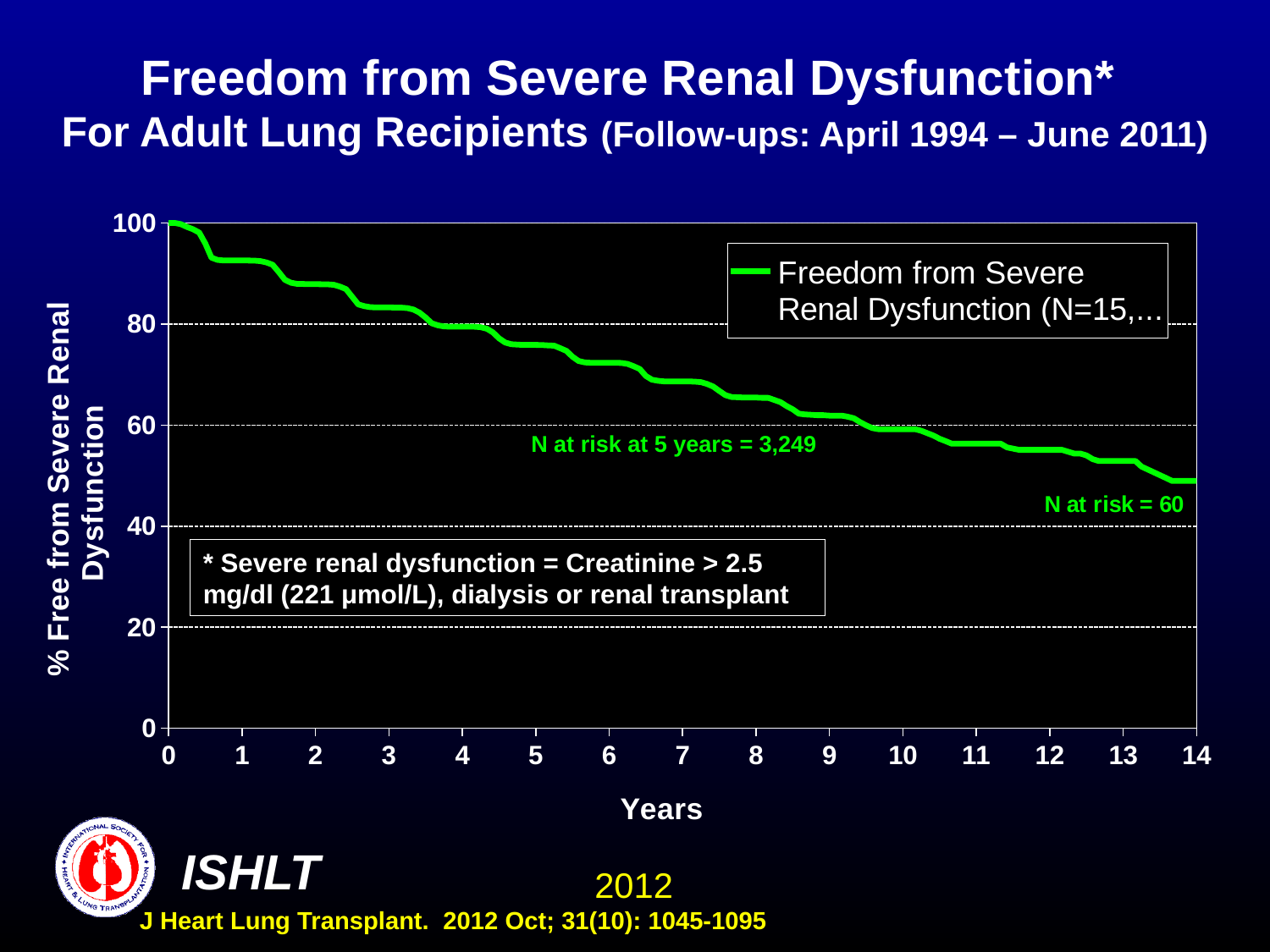
Is the % free from severe renal dysfunction at year 12 greater or less than 60? less According to the annotation near the end of the curve, what is the N at risk? 60 Which year has the higher % free from severe renal dysfunction, year 3 or year 9? year 3 Is the % free from severe renal dysfunction at year 14 greater or less than 60? less What is the % free from severe renal dysfunction at year 0? 100 According to the annotation on the chart, what is the N at risk at 5 years? 3,249 Does the freedom from severe renal dysfunction curve rise or fall as years increase? fall How many series does the legend list? 1 What kind of chart is shown on the slide? line chart Is the % free from severe renal dysfunction at year 7 greater or less than 60? greater